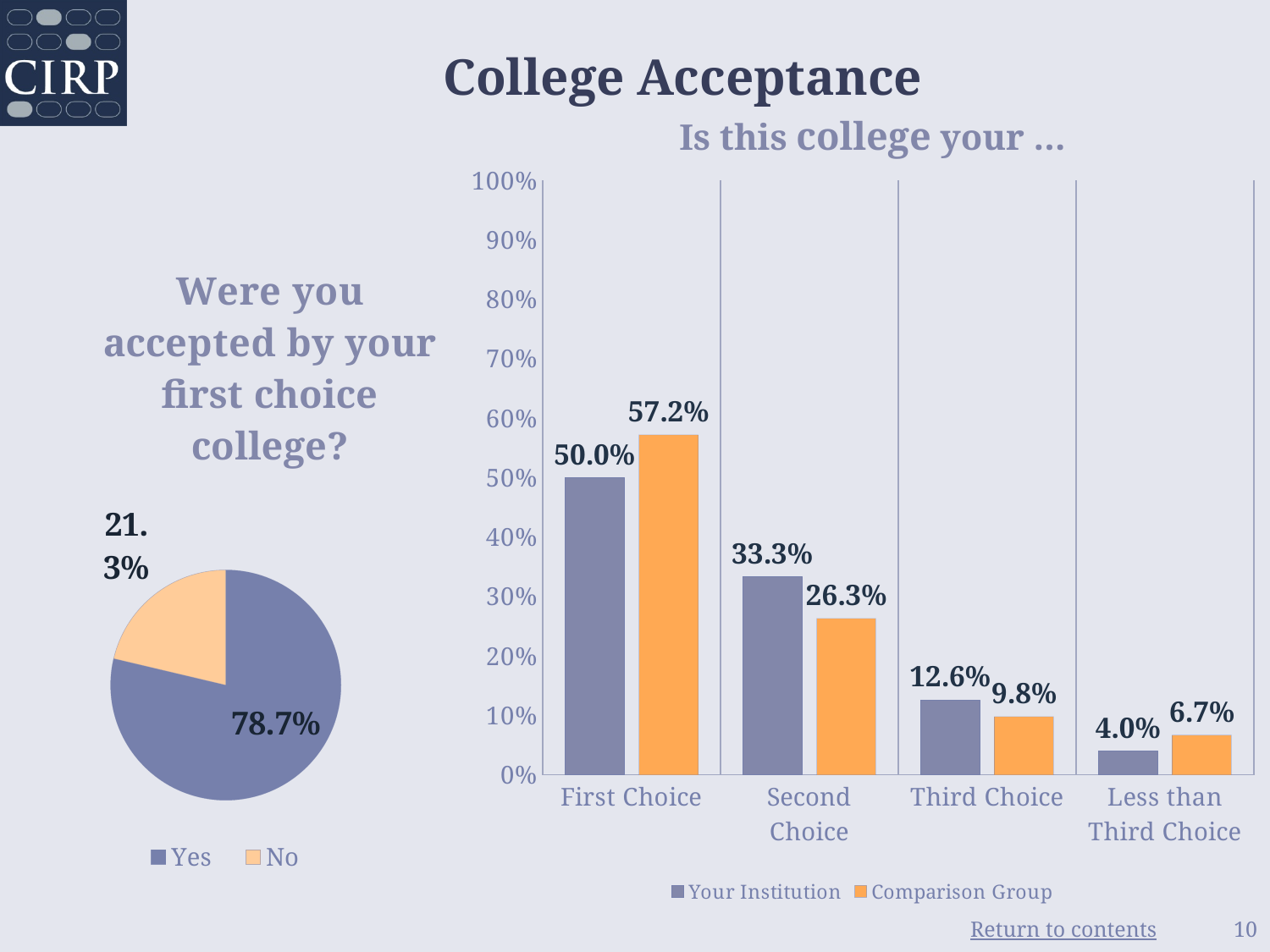
How many series does the legend of the bar chart 'Is this college your ...' list? 2 In the bar chart 'Is this college your ...', what is the difference between Comparison Group and Your Institution for First Choice? 7.2% In the bar chart 'Is this college your ...', what is the value for Your Institution for Less than Third Choice? 4.0% In the pie chart 'Were you accepted by your first choice college?', what percentage answered No? 21.3% In the bar chart 'Is this college your ...', what is the value for Your Institution for First Choice? 50.0% In the pie chart 'Were you accepted by your first choice college?', what percentage answered Yes? 78.7% In the bar chart 'Is this college your ...', what is the value for Comparison Group for Second Choice? 26.3% In the bar chart 'Is this college your ...', which is larger for Third Choice: Your Institution or Comparison Group? Your Institution In the bar chart 'Is this college your ...', which category has the lowest value for Your Institution? Less than Third Choice What kind of chart is the chart on the left of the slide? pie chart What kind of chart is the chart titled 'Is this college your ...'? bar chart In the bar chart 'Is this college your ...', which category has the highest value for Comparison Group? First Choice